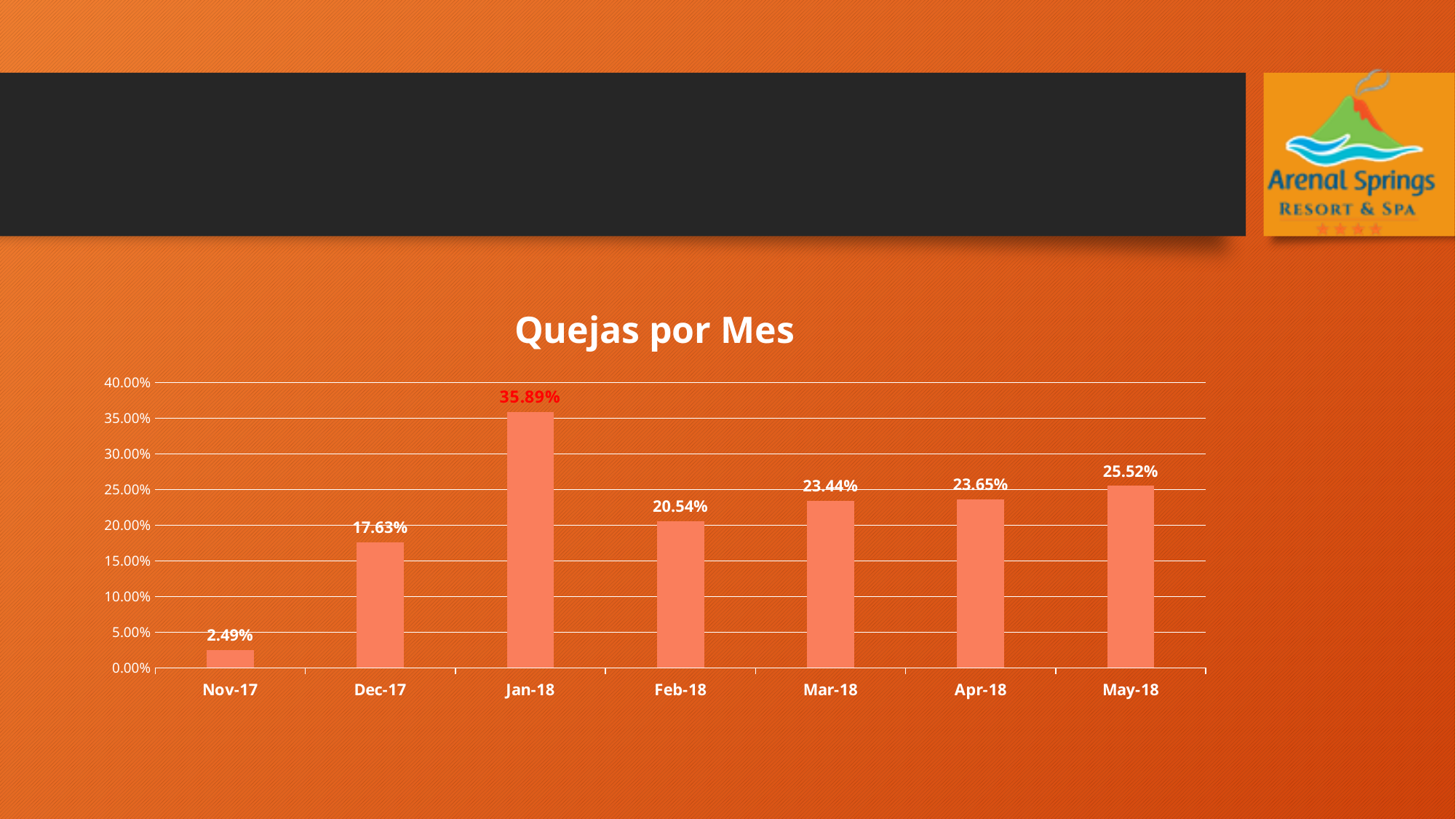
Which month has the lowest value? Nov-17 Do the values rise or fall from Feb-18 to May-18? Rise Which is larger, the value for Dec-17 or the value for May-18? May-18 How many months are shown on the x axis? 7 What is the value for Nov-17? 2.49% What is the difference between the values for Jan-18 and Feb-18? 15.35% What is the title of the chart? Quejas por Mes Which month has the highest value? Jan-18 Is the value for Mar-18 greater or less than 20.00%? greater What kind of chart is this? Bar chart What is the value for Jan-18? 35.89% What is the value for Apr-18? 23.65%